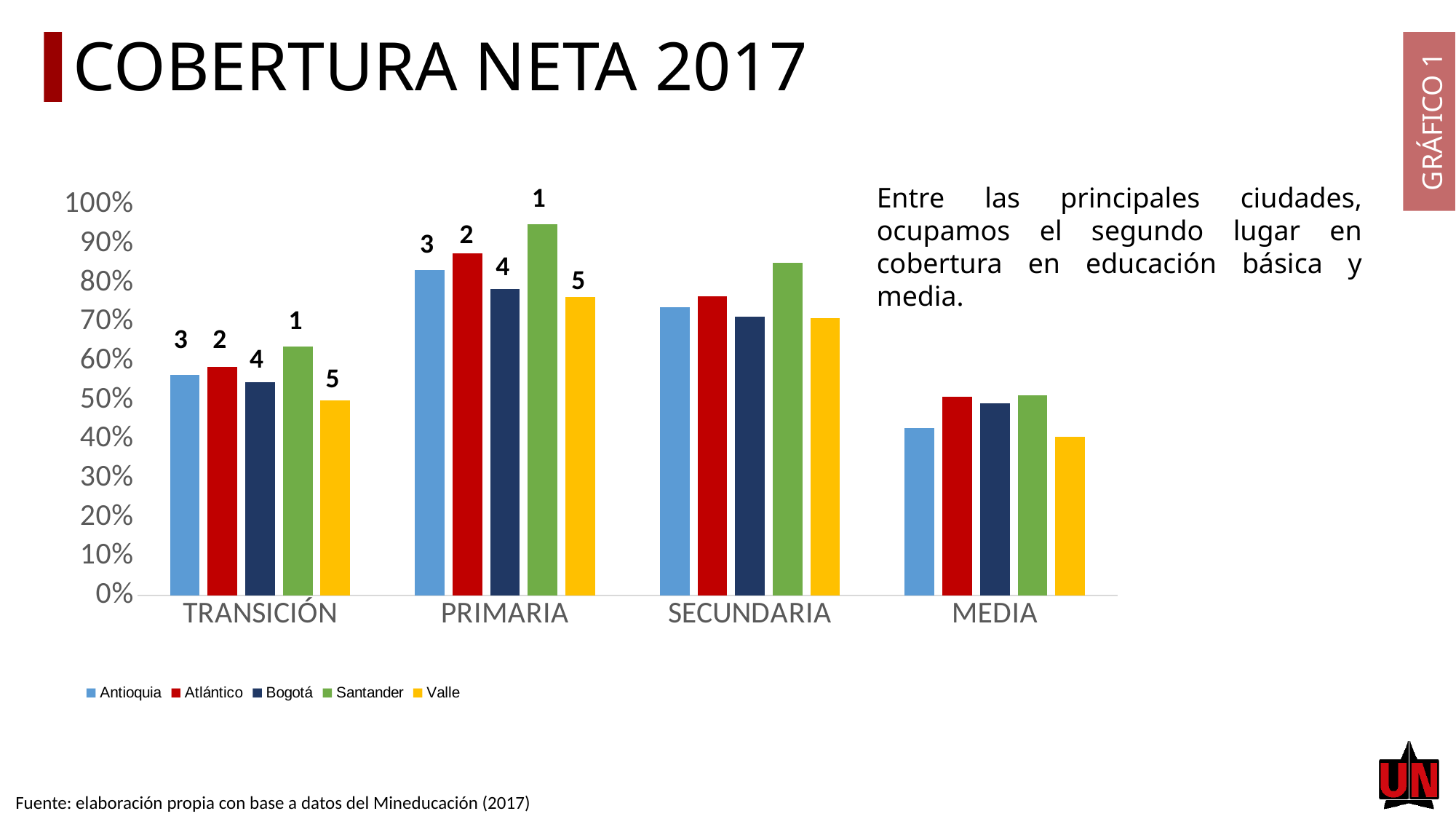
How many education levels (categories) are shown on the x axis? 4 What colour represents Santander in the legend? green Which department has the lowest bar in the MEDIA group? Valle Which department has the highest bar in the PRIMARIA group? Santander In the TRANSICIÓN group, which is larger: the Santander bar or the Valle bar? Santander Which department has the highest bar in the SECUNDARIA group? Santander Which department has the lowest bar in the TRANSICIÓN group? Valle How many series does the legend list? 5 Is the value for Santander in PRIMARIA greater or less than 90%? greater What type of chart is shown on the slide? bar chart What data label is printed above the Valle bar in the TRANSICIÓN group? 5 Is the value for Valle in MEDIA greater or less than 50%? less